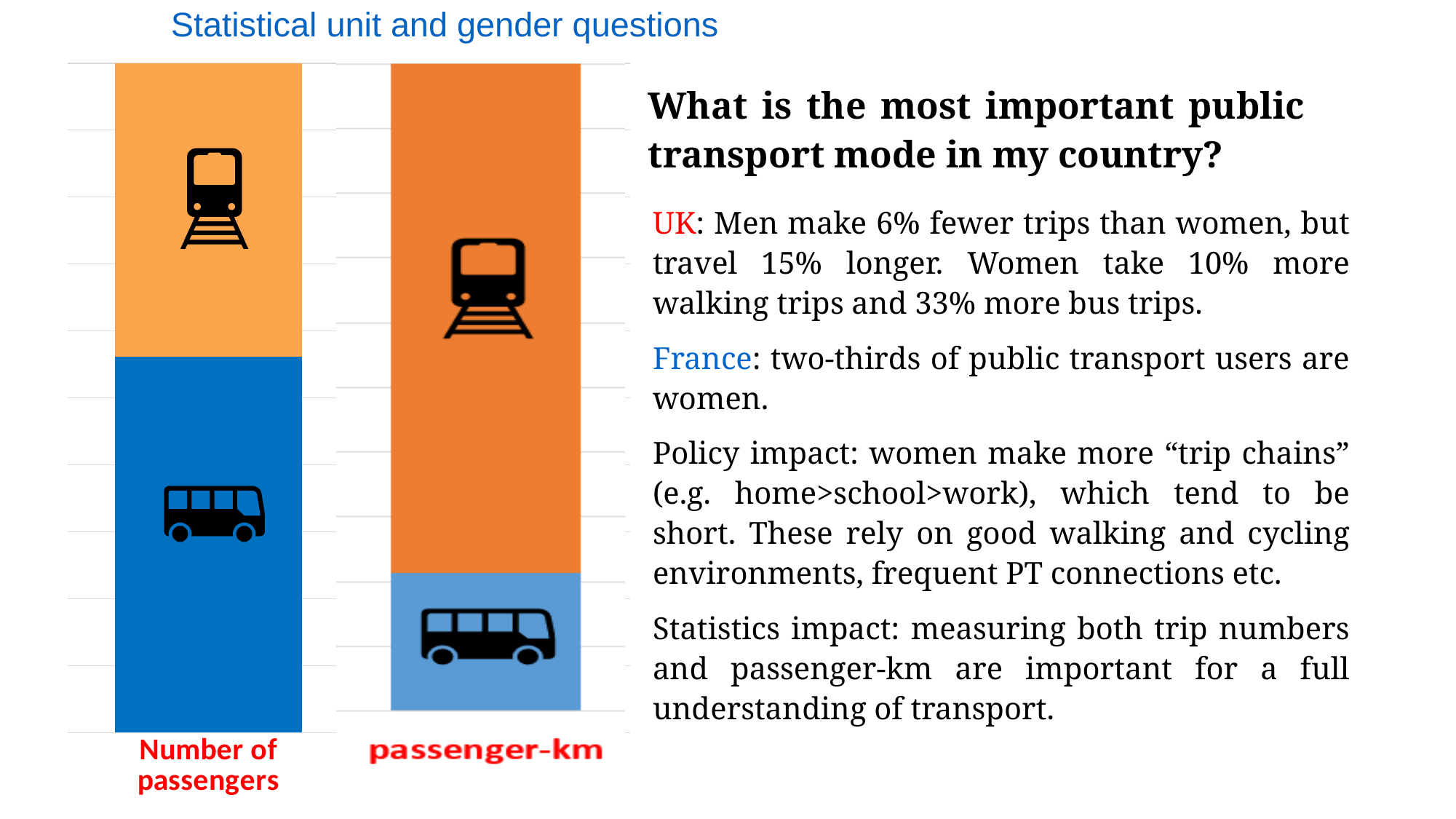
In the "passenger-km" bar, which segment is larger, the bus segment or the train segment? train What kind of chart is shown on the left of the slide? stacked bar chart Which bar has the larger train segment, "Number of passengers" or "passenger-km"? passenger-km How many transport modes are stacked in each bar? 2 Which bar has the larger bus segment, "Number of passengers" or "passenger-km"? Number of passengers Which transport mode is represented by the bottom segment of each bar? bus What are the labels of the two bars in the chart? Number of passengers; passenger-km How many bars does the chart show? 2